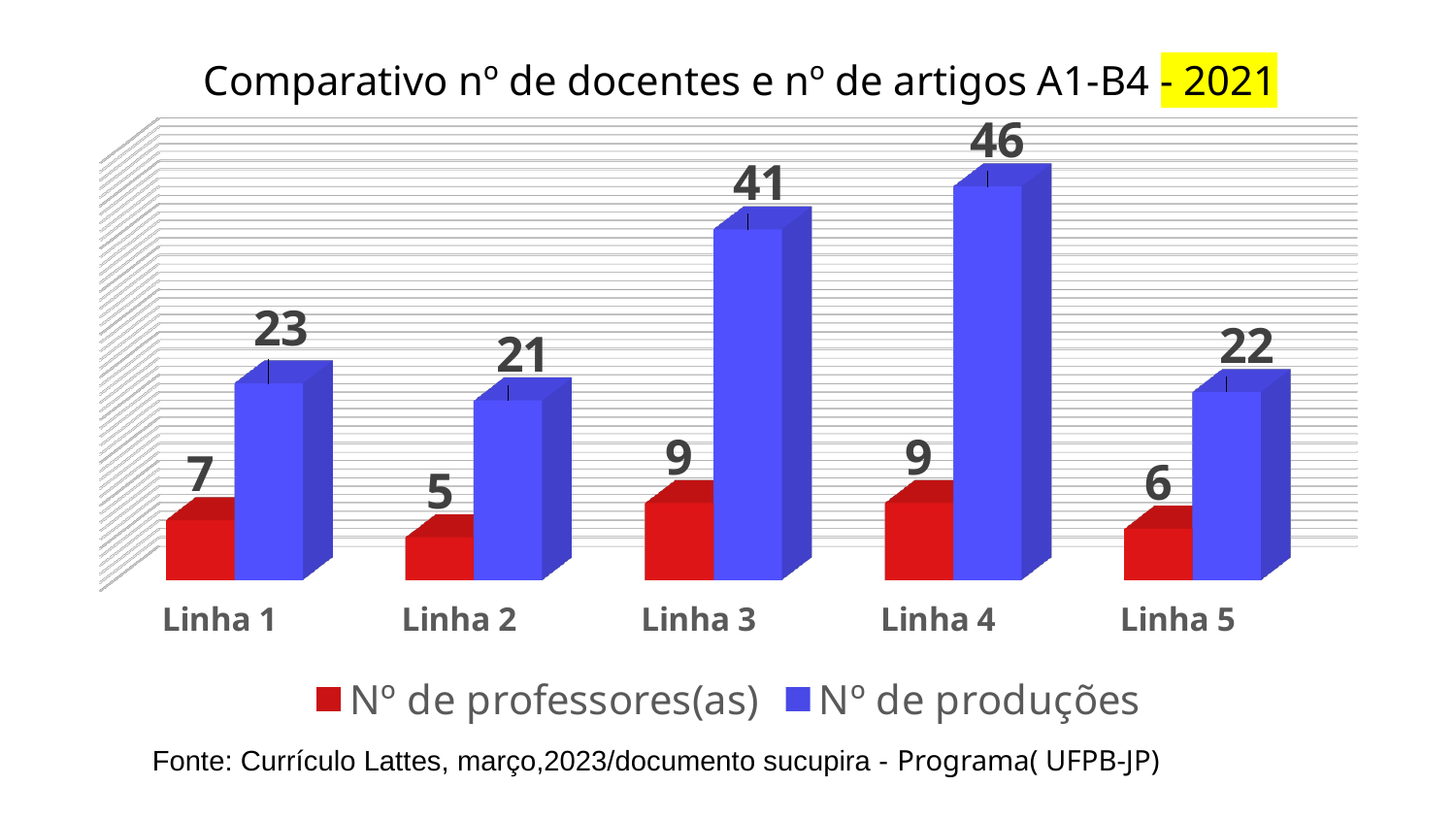
What is the value of Nº de produções for Linha 5? 22 What is the difference between Nº de produções and Nº de professores(as) for Linha 3? 32 Which category has the lowest value for Nº de professores(as)? Linha 2 Which category has the highest value for Nº de produções? Linha 4 What kind of chart is shown on the slide? Bar chart Which is larger: Nº de produções for Linha 1 or for Linha 2? Linha 1 How many series does the legend list? 2 What is the value of Nº de professores(as) for Linha 2? 5 What is the difference between Nº de produções for Linha 4 and Linha 1? 23 How many categories are shown on the x axis? 5 What is the value of Nº de produções for Linha 3? 41 What colour represents Nº de professores(as) in the chart? Red